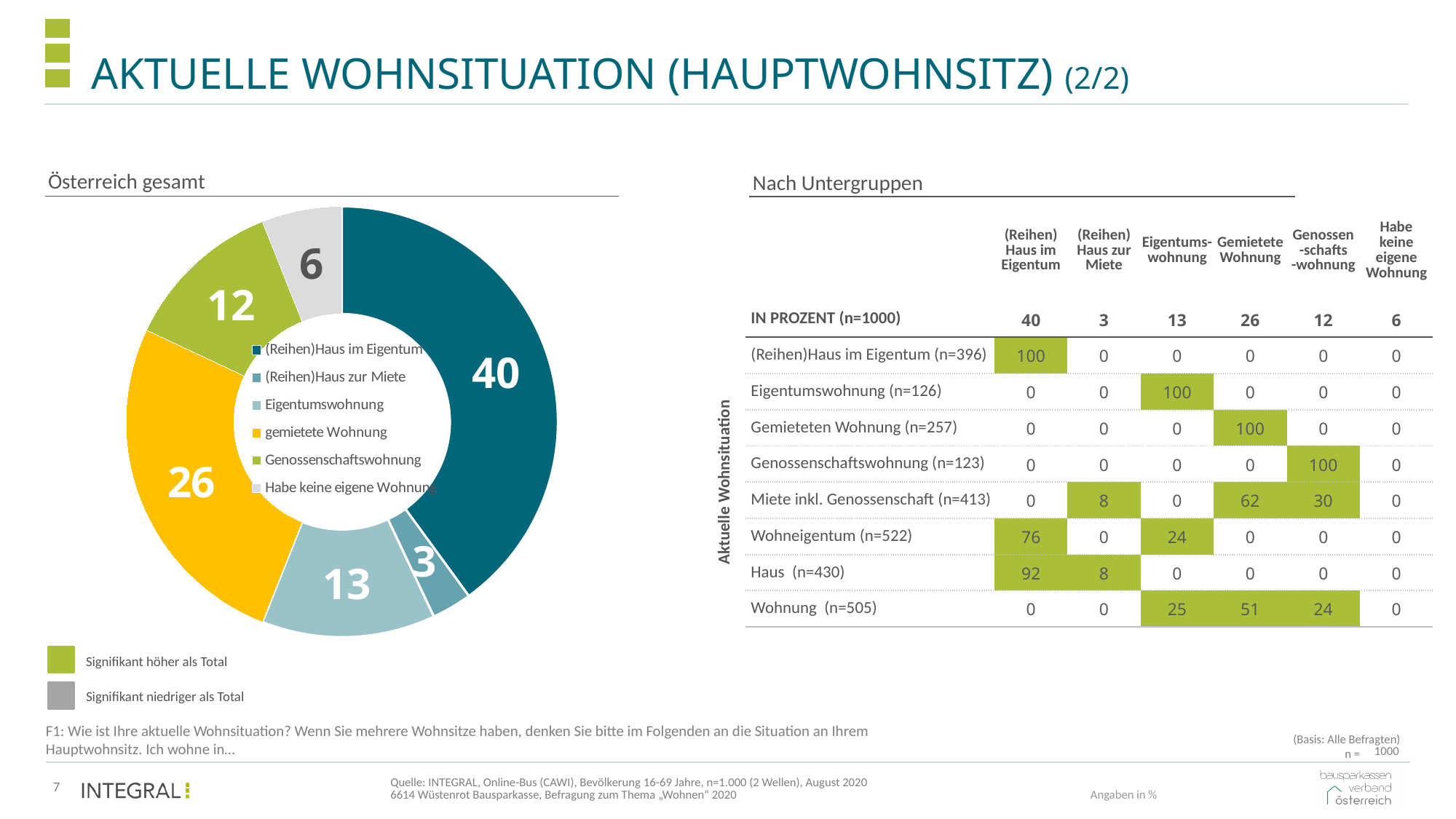
In the "Österreich gesamt" chart, what is the value for gemietete Wohnung? 26 In the "Österreich gesamt" chart, which category has the smallest share? (Reihen)Haus zur Miete In the "Österreich gesamt" chart, what is the value for (Reihen)Haus zur Miete? 3 What kind of chart is shown under "Österreich gesamt"? Pie chart (donut) How many categories does the "Österreich gesamt" chart show? 6 In the "Österreich gesamt" chart, what is the value for Eigentumswohnung? 13 In the "Österreich gesamt" chart, what colour is the gemietete Wohnung slice? Yellow In the "Österreich gesamt" chart, which is larger: Genossenschaftswohnung or Eigentumswohnung? Eigentumswohnung In the "Österreich gesamt" chart, which category has the largest share? (Reihen)Haus im Eigentum In the "Österreich gesamt" chart, what is the value for Habe keine eigene Wohnung? 6 In the "Österreich gesamt" chart, what is the difference between the values for (Reihen)Haus im Eigentum and gemietete Wohnung? 14 In the "Österreich gesamt" chart, what is the value for (Reihen)Haus im Eigentum? 40